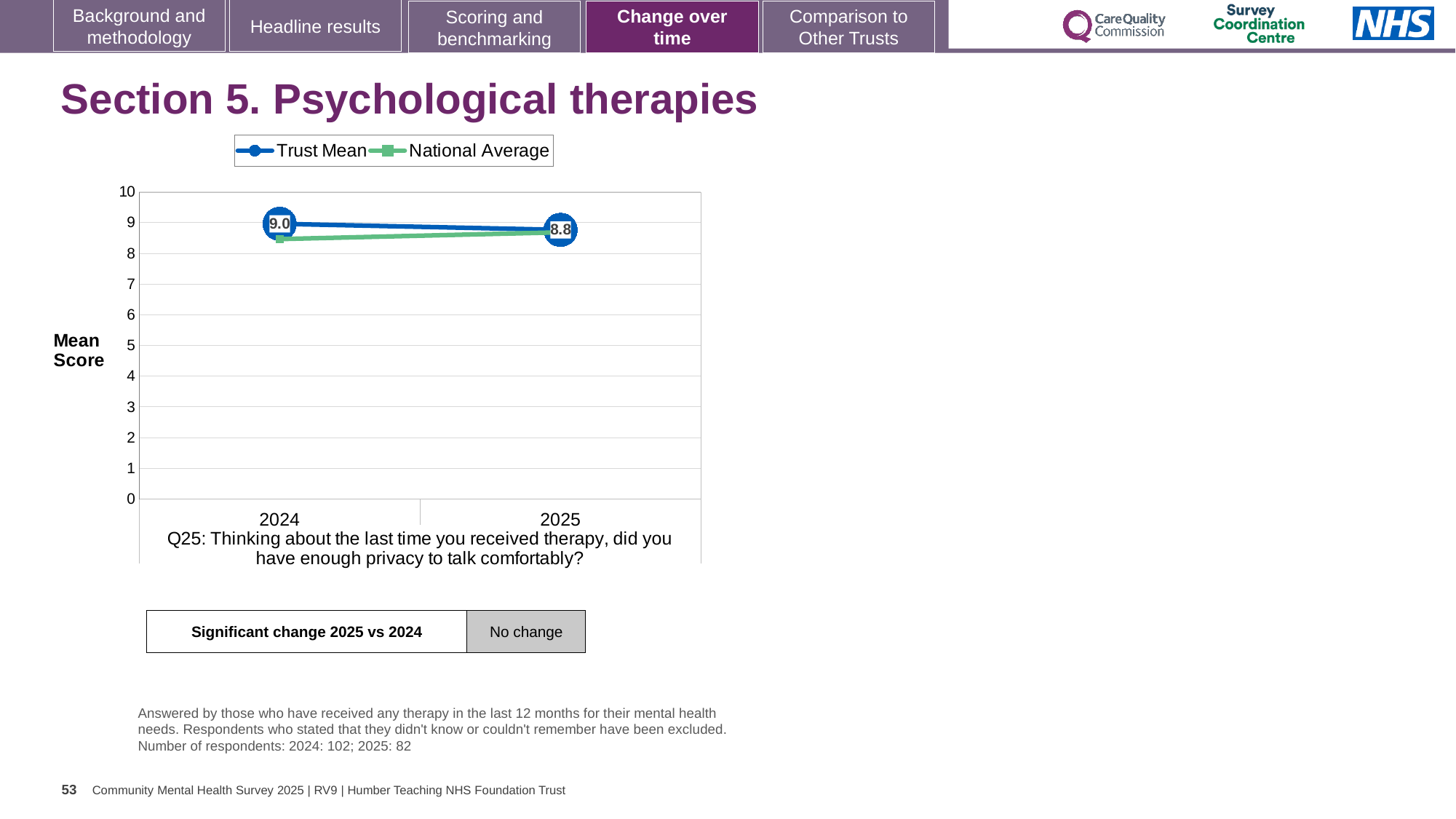
How many series does the legend list? 2 What type of chart is shown on the slide? line chart What is the Trust Mean score for 2025? 8.8 Does the National Average rise or fall from 2024 to 2025? rise Does the Trust Mean rise or fall from 2024 to 2025? fall Is the National Average value for 2025 greater or less than 8? greater Is the National Average value for 2024 greater or less than 9? less How many years are shown on the x axis? 2 In 2024, which is higher, the Trust Mean or the National Average? Trust Mean In which year is the Trust Mean score higher, 2024 or 2025? 2024 By how much did the Trust Mean score change from 2024 to 2025? 0.2 What is the Trust Mean score for 2024? 9.0